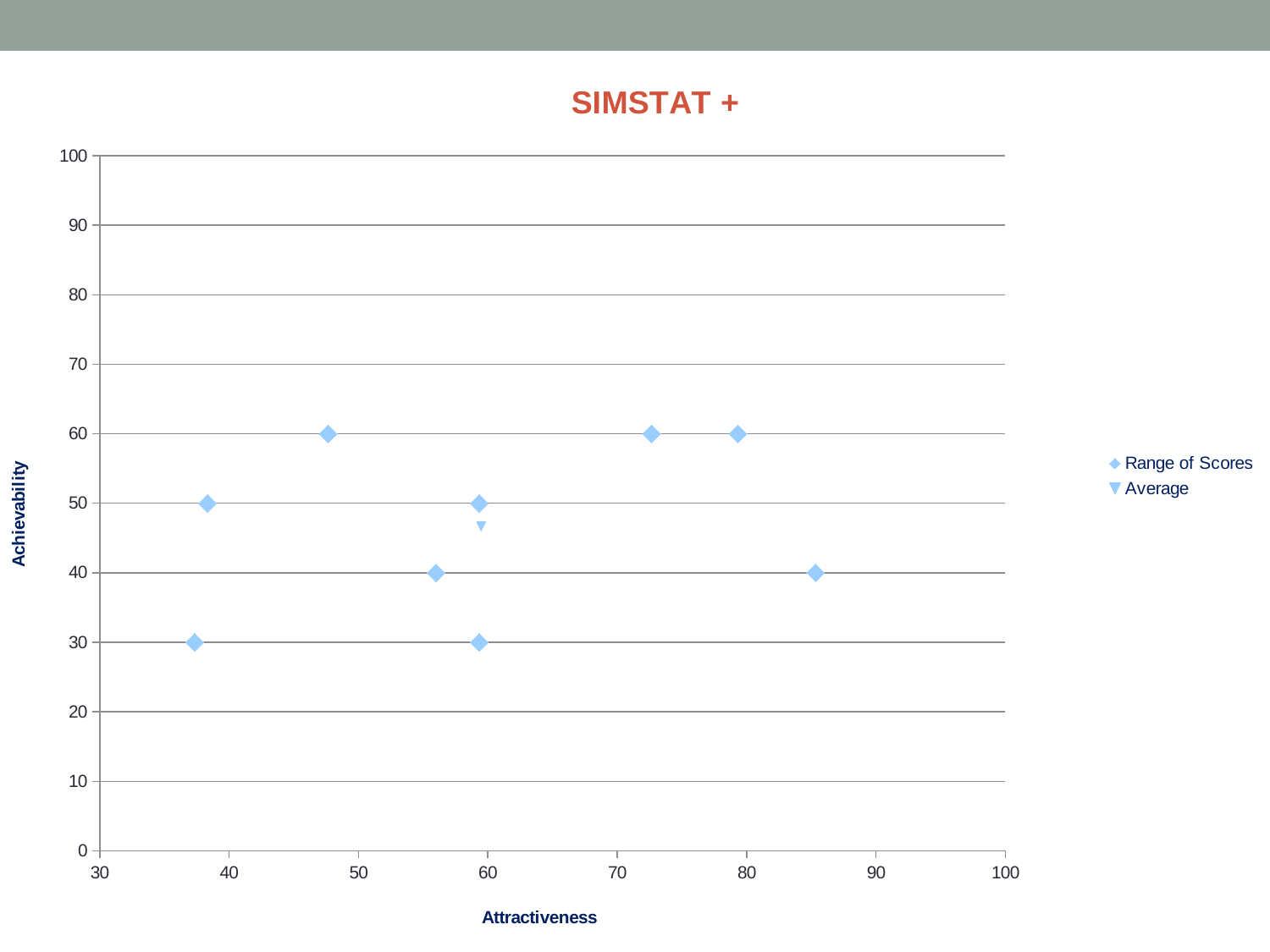
How many Average points are plotted on the chart? 1 What is the highest Achievability value reached by any Range of Scores point? 60 Is the Attractiveness of the Average point greater or less than 50? greater How many Range of Scores points are plotted on the chart? 9 Is the Achievability of the Average point greater or less than 50? less Which has the higher Achievability: the Range of Scores point near Attractiveness 85 or the Range of Scores point near Attractiveness 80? the point near Attractiveness 80 How many Range of Scores points have an Achievability of 60? 3 What kind of chart is shown on the slide? scatter chart How many series does the legend list? 2 What is the title of the chart? SIMSTAT + What is the lowest Achievability value reached by any Range of Scores point? 30 What are the two series named in the legend? Range of Scores and Average